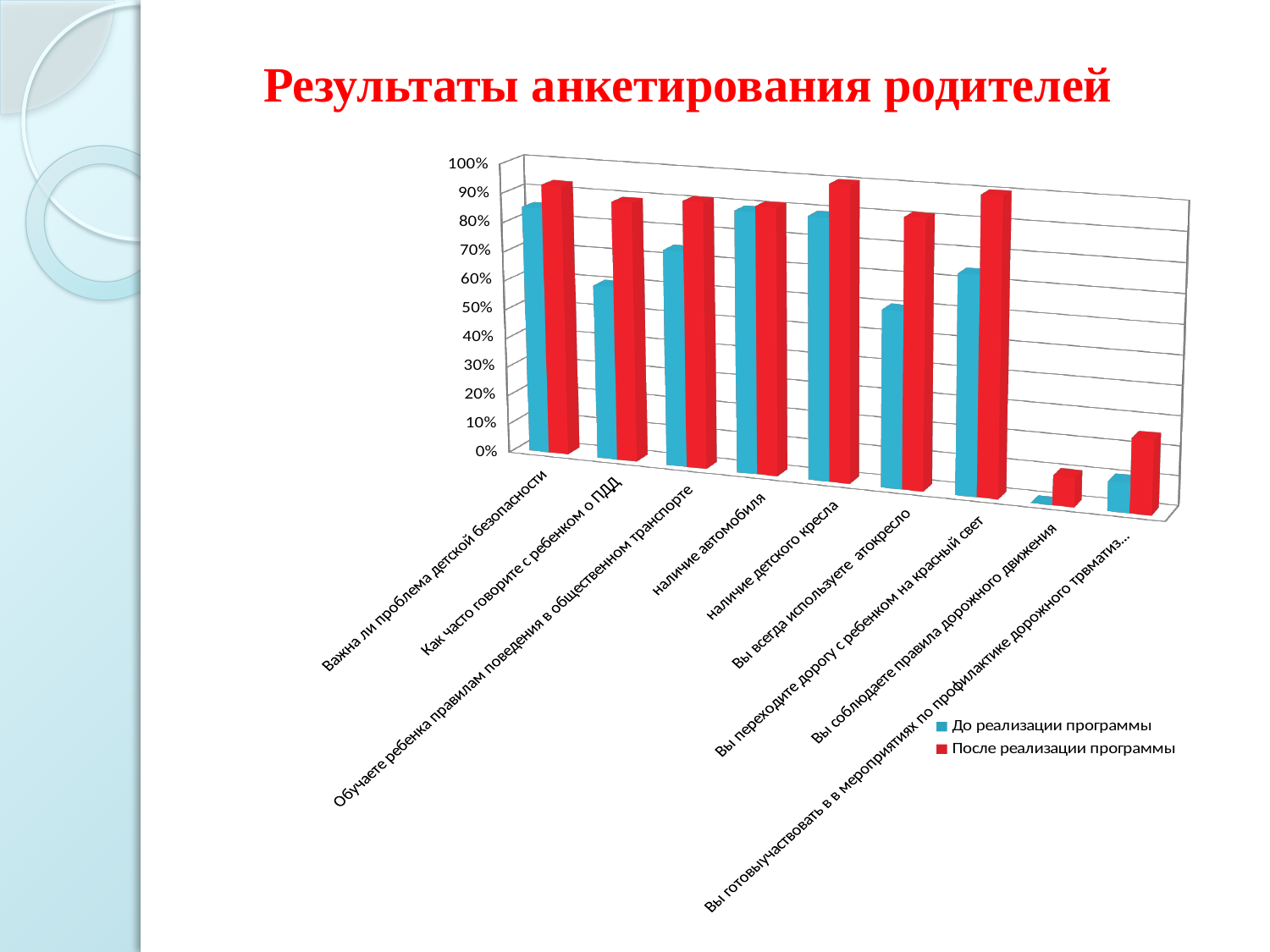
What is the title of the slide containing the chart? Результаты анкетирования родителей Is the value for "Вы соблюдаете правила дорожного движения" in the series "После реализации программы" greater or less than 30%? less Is the value for "Вы всегда используете атокресло" in the series "До реализации программы" greater or less than 70%? less Which category has the lowest value in the series "До реализации программы"? Вы соблюдаете правила дорожного движения For "Как часто говорите с ребенком о ПДД", which series has the larger value: "До реализации программы" or "После реализации программы"? После реализации программы How many categories are shown along the x axis of the chart? 9 Is the value for "Как часто говорите с ребенком о ПДД" in the series "До реализации программы" greater or less than 70%? less For "Вы всегда используете атокресло", which series has the larger value: "До реализации программы" or "После реализации программы"? После реализации программы How many series does the chart legend list? 2 What kind of chart is shown on the slide? bar chart Which series is shown in red in the chart? После реализации программы